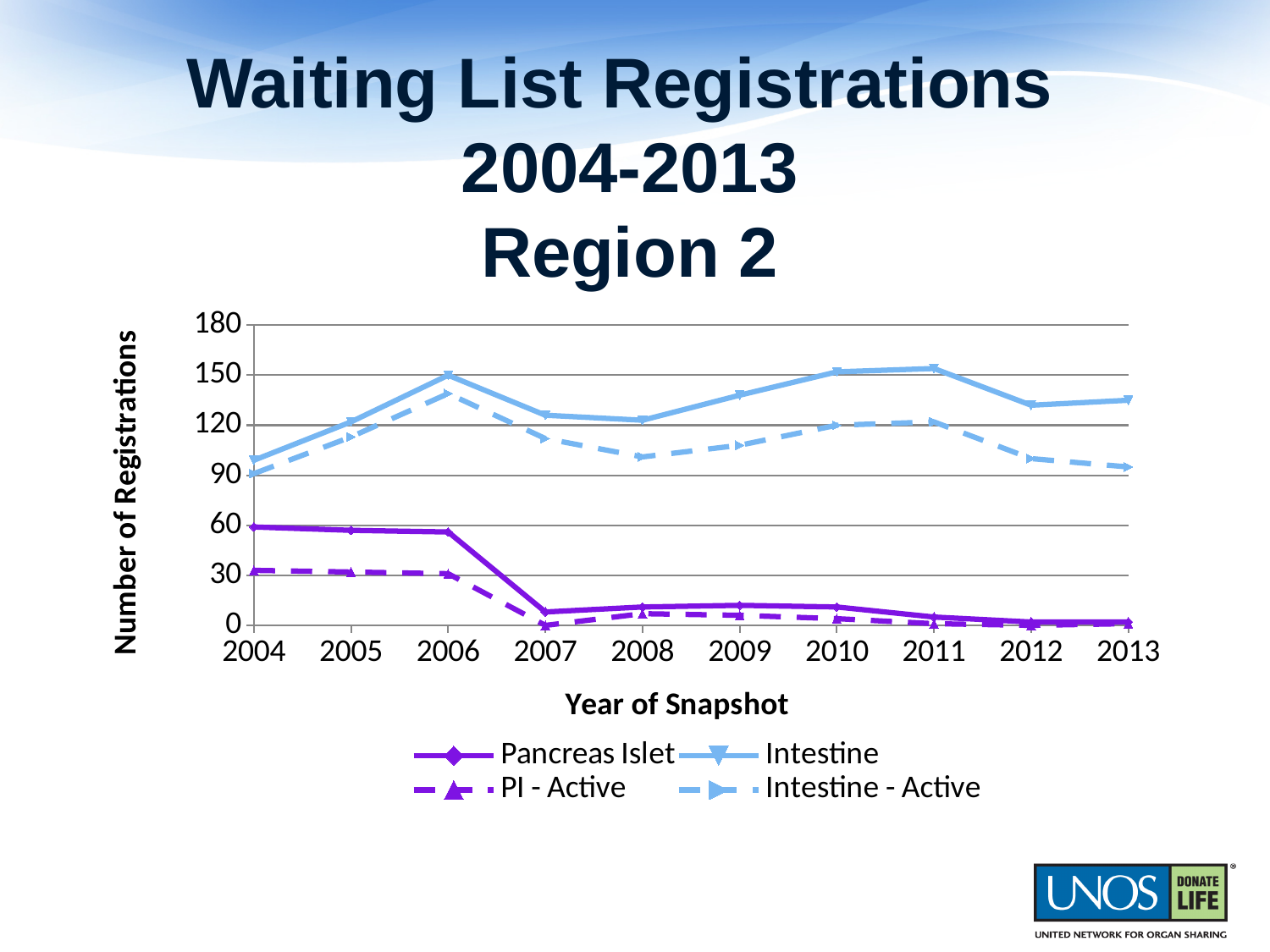
Which year has the larger Pancreas Islet value, 2006 or 2007? 2006 How many years are plotted along the x axis? 10 Is the value for Pancreas Islet in 2007 greater or less than 30? less What kind of chart is shown on the slide? line chart Is the value for Intestine in 2004 greater or less than 120? less Is the value for Intestine - Active in 2008 greater or less than 90? greater Which series has the larger value in 2010, Intestine or Pancreas Islet? Intestine In which year is the Intestine series at its lowest? 2004 How many series does the legend list? 4 What is the label of the y axis? Number of Registrations Does the Pancreas Islet series generally rise or fall from 2004 to 2013? fall